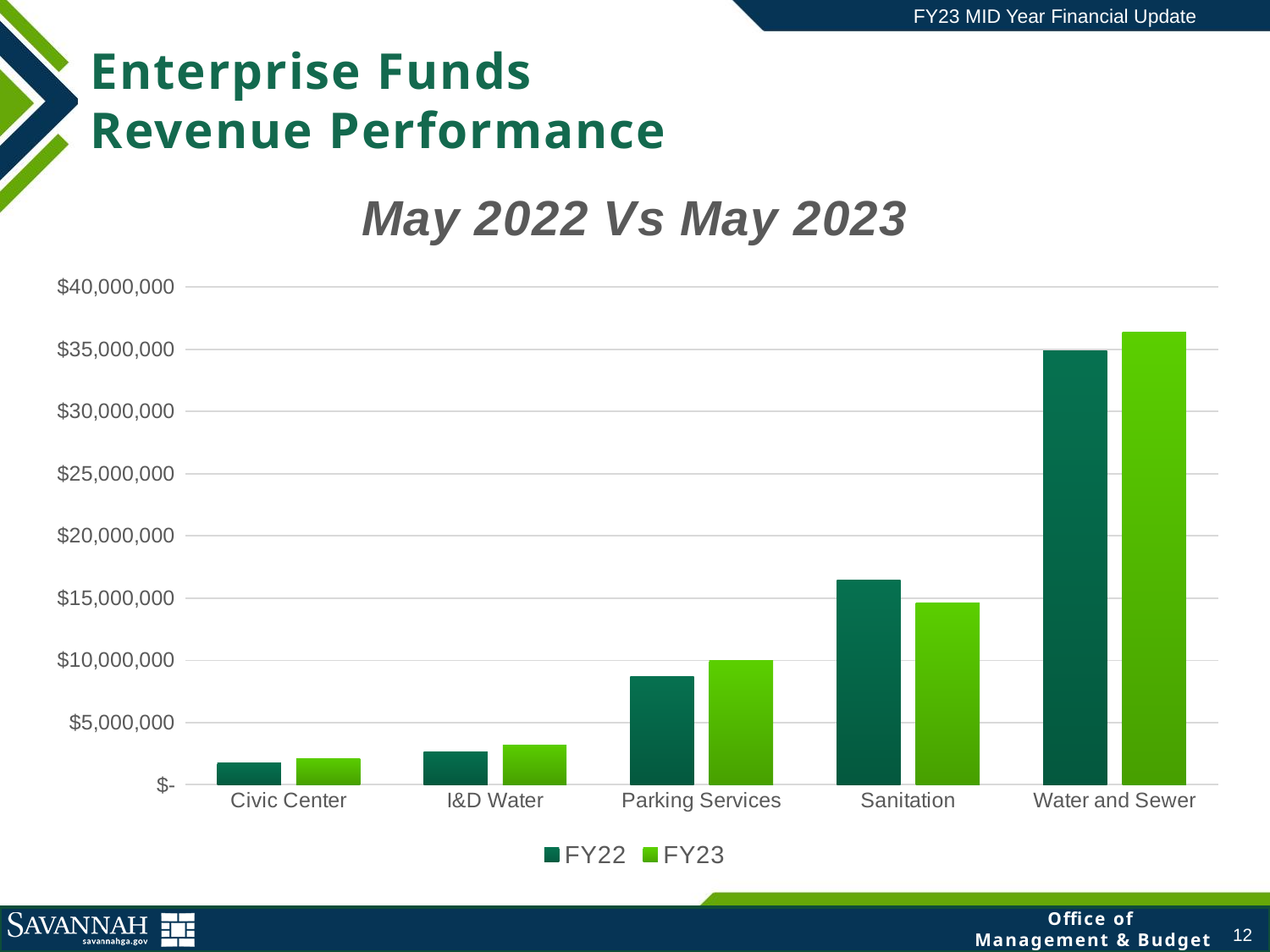
What is the title shown above the chart? May 2022 Vs May 2023 Which category has the lowest FY22 revenue? Civic Center Is the FY22 value for Sanitation greater or less than $15,000,000? greater For Parking Services, which is larger, the FY22 or the FY23 value? FY23 Is the FY22 value for Parking Services greater or less than $10,000,000? less How many enterprise fund categories are shown on the x axis? 5 Which category has the highest FY23 revenue? Water and Sewer What kind of chart is shown on the slide? Bar chart How many series does the legend list? 2 For Sanitation, which is larger, the FY22 or the FY23 value? FY22 Is the FY23 value for Water and Sewer greater or less than $35,000,000? greater What are the two series named in the legend? FY22 and FY23